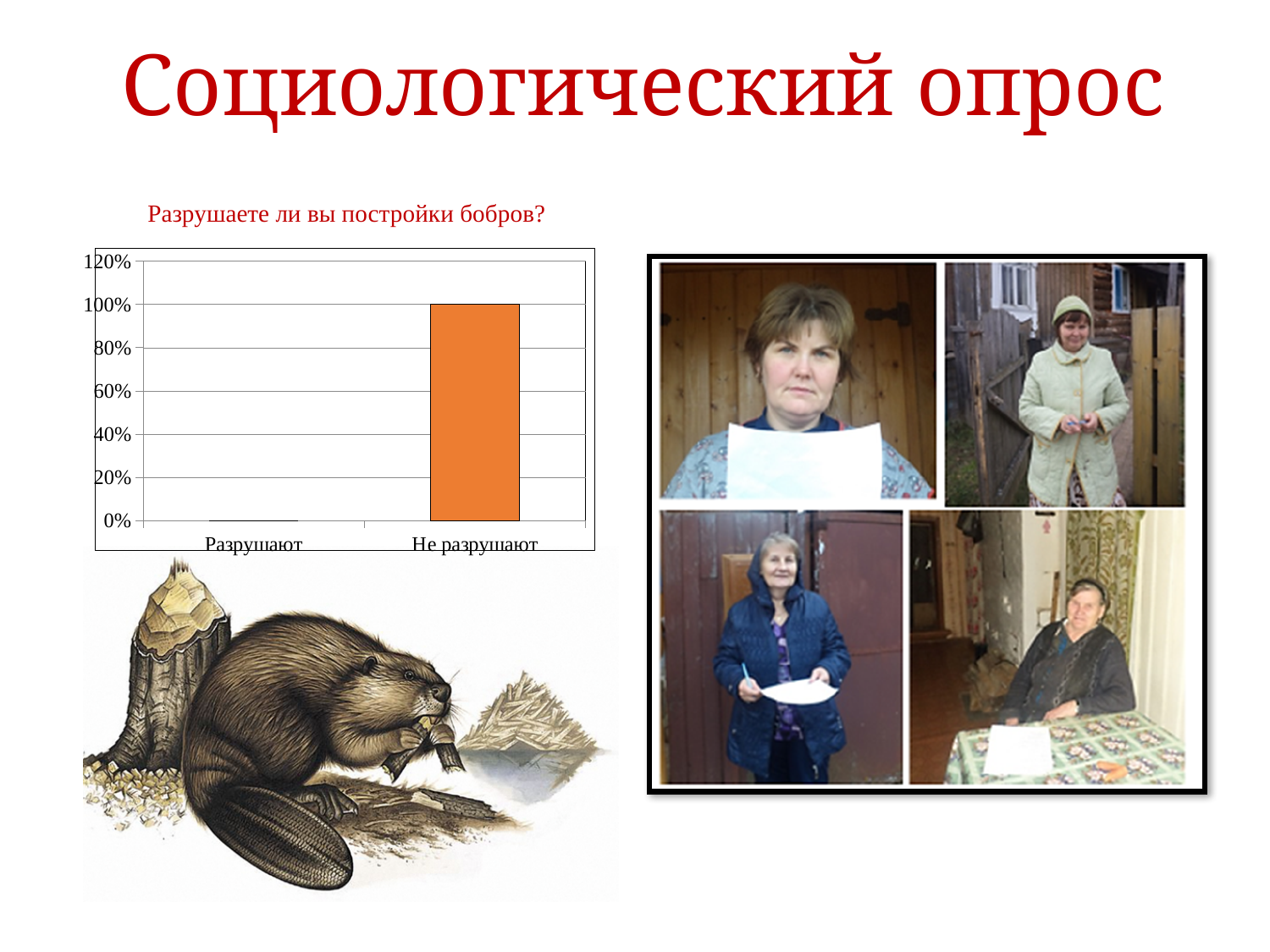
Which category has the lowest value in the chart? Разрушают What is the highest value shown on the chart's vertical axis? 120% What question is written above the chart as its title? Разрушаете ли вы постройки бобров? Is the value for "Не разрушают" greater or less than 80%? greater What kind of chart is shown on the slide? bar chart What is the value for "Не разрушают" in the chart? 100% What is the value for "Разрушают" in the chart? 0% How many categories are shown on the x axis of the chart? 2 Which category has the highest value in the chart? Не разрушают Which is larger in the chart, the value for "Разрушают" or for "Не разрушают"? Не разрушают What is the difference between the values for "Не разрушают" and "Разрушают"? 100% Is the value for "Разрушают" greater or less than 20%? less